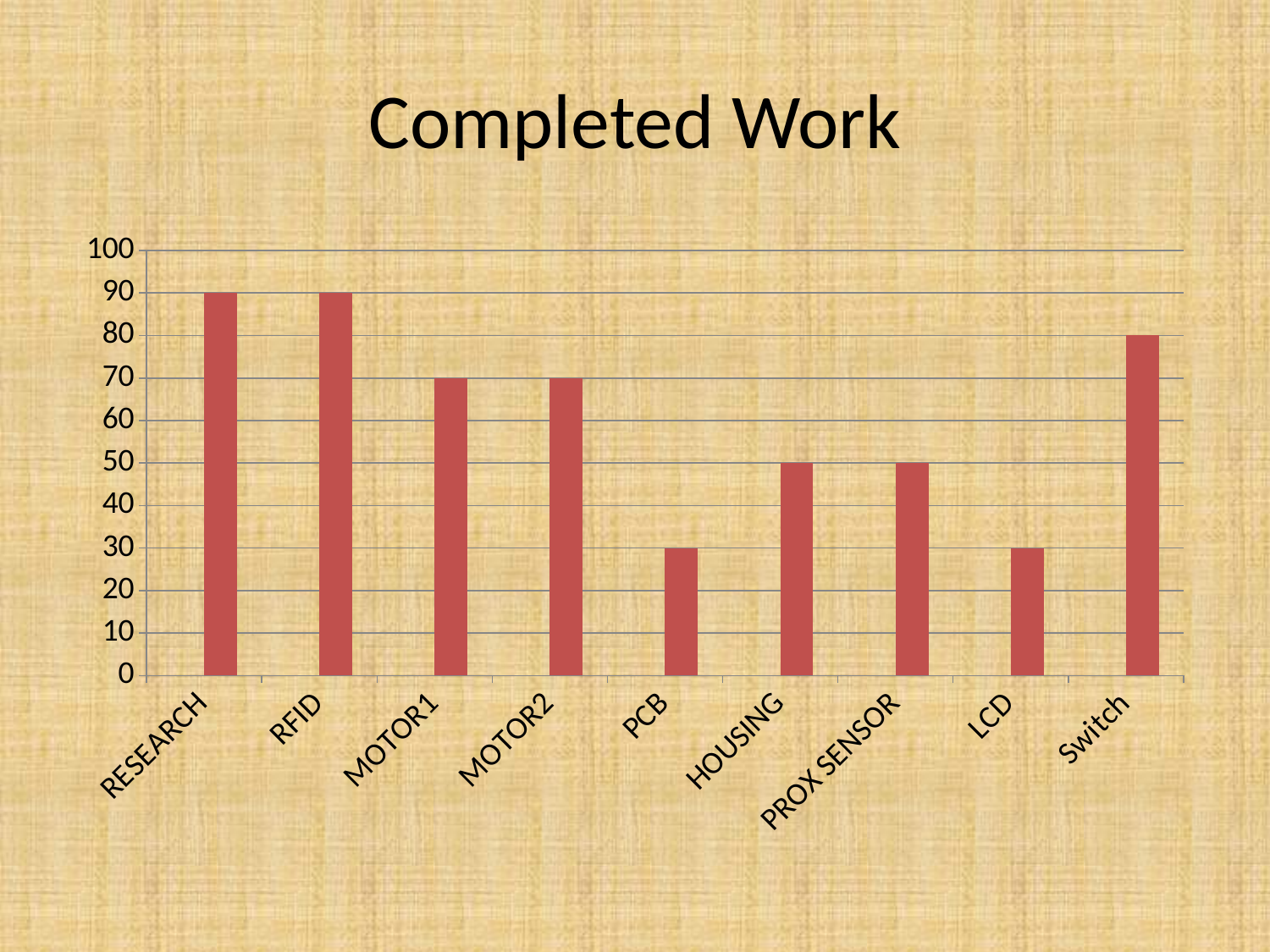
What is the value for RESEARCH? 90 What is the title of the chart? Completed Work What is the value for MOTOR2? 70 What kind of chart is shown on the slide? Bar chart What is the difference between the values for Switch and PROX SENSOR? 30 Which is larger, the value for MOTOR1 or the value for HOUSING? MOTOR1 Which is larger, the value for LCD or the value for Switch? Switch What is the value for Switch? 80 What is the difference between the values for RFID and LCD? 60 What is the value for HOUSING? 50 What is the value for PCB? 30 How many categories are shown on the x axis? 9